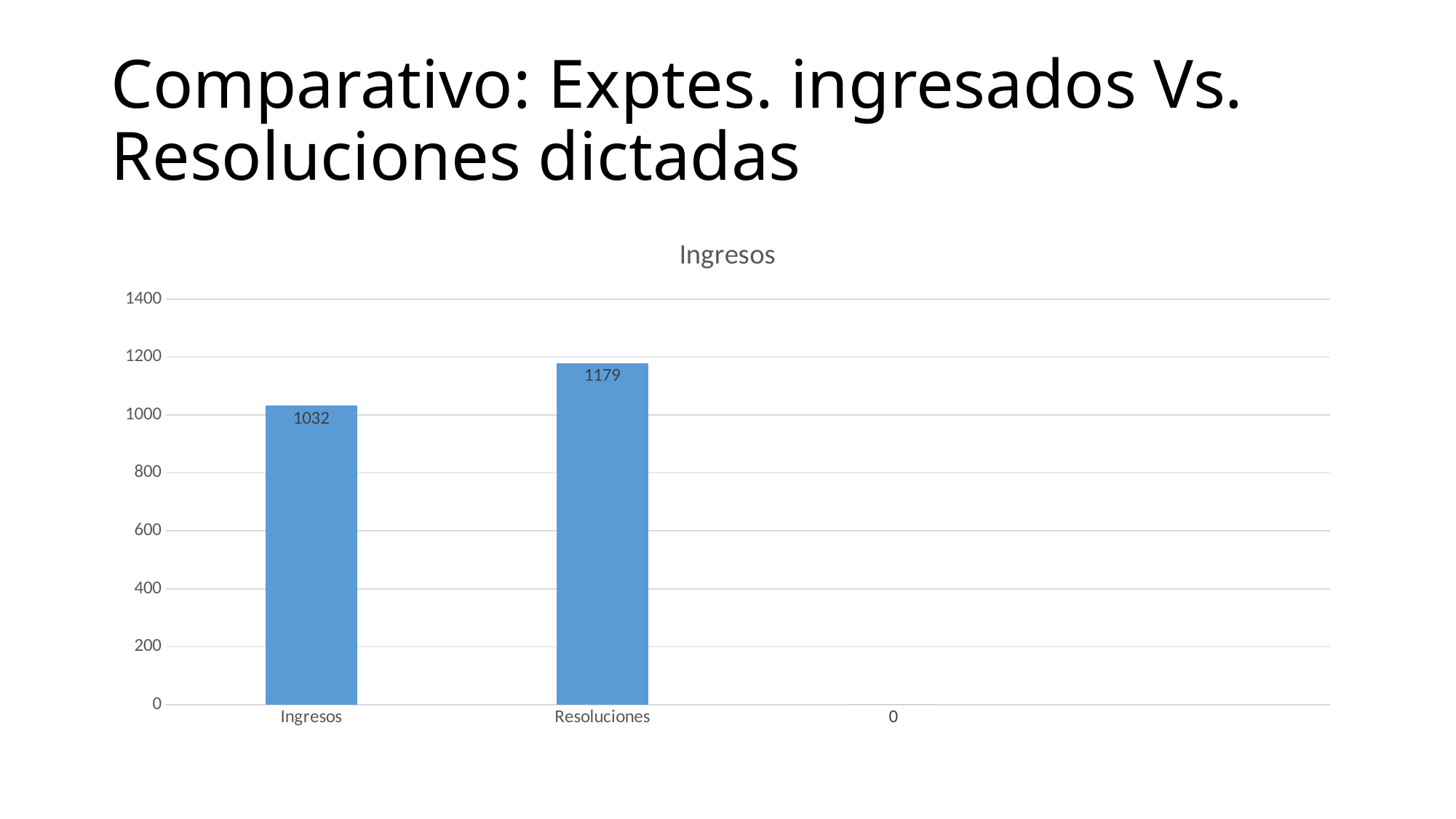
What is the value for Resoluciones? 1179 Which category has the lowest value among the bars shown? Ingresos Which is larger, Ingresos or Resoluciones? Resoluciones What is the title of the chart? Ingresos Which category has the highest value? Resoluciones What is the value for Ingresos? 1032 What is the highest value shown on the vertical axis? 1400 Is the value for Resoluciones greater or less than 1200? less What is the difference between the values for Resoluciones and Ingresos? 147 How many bars are plotted on the chart? 2 What kind of chart is shown? Bar chart Is the value for Ingresos greater or less than 1000? greater